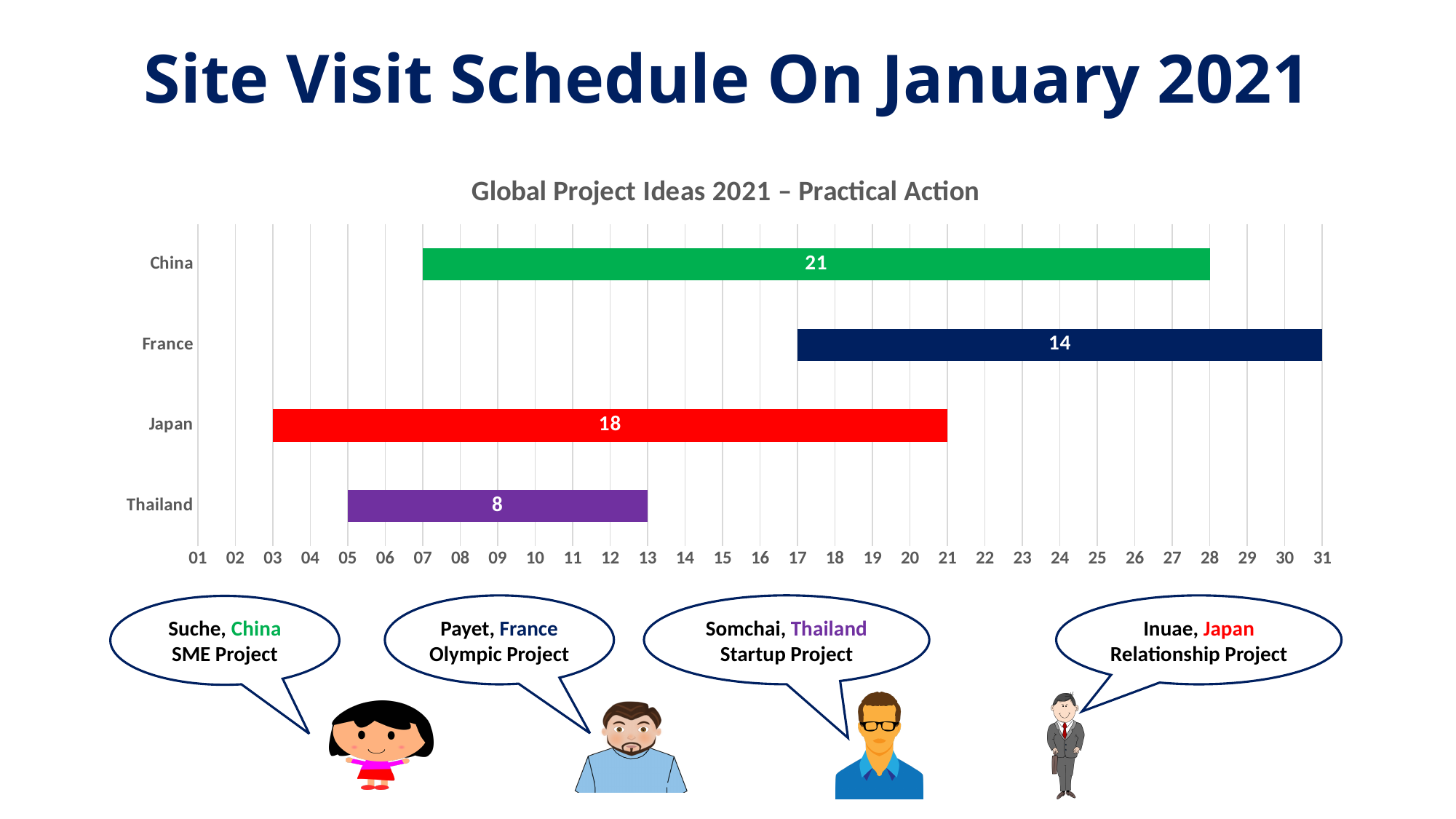
What is the value shown on the bar for China? 21 What is the title of the chart? Global Project Ideas 2021 – Practical Action What is the value shown on the bar for Thailand? 8 What is the difference between the values for Japan and France? 4 How many countries are shown in the chart? 4 What is the value shown on the bar for France? 14 What is the value shown on the bar for Japan? 18 What kind of chart is shown on the slide? Bar chart What is the difference between the values for China and Thailand? 13 Which country has the highest value in the chart? China Which has a larger value, France or Japan? Japan Which country has the lowest value in the chart? Thailand